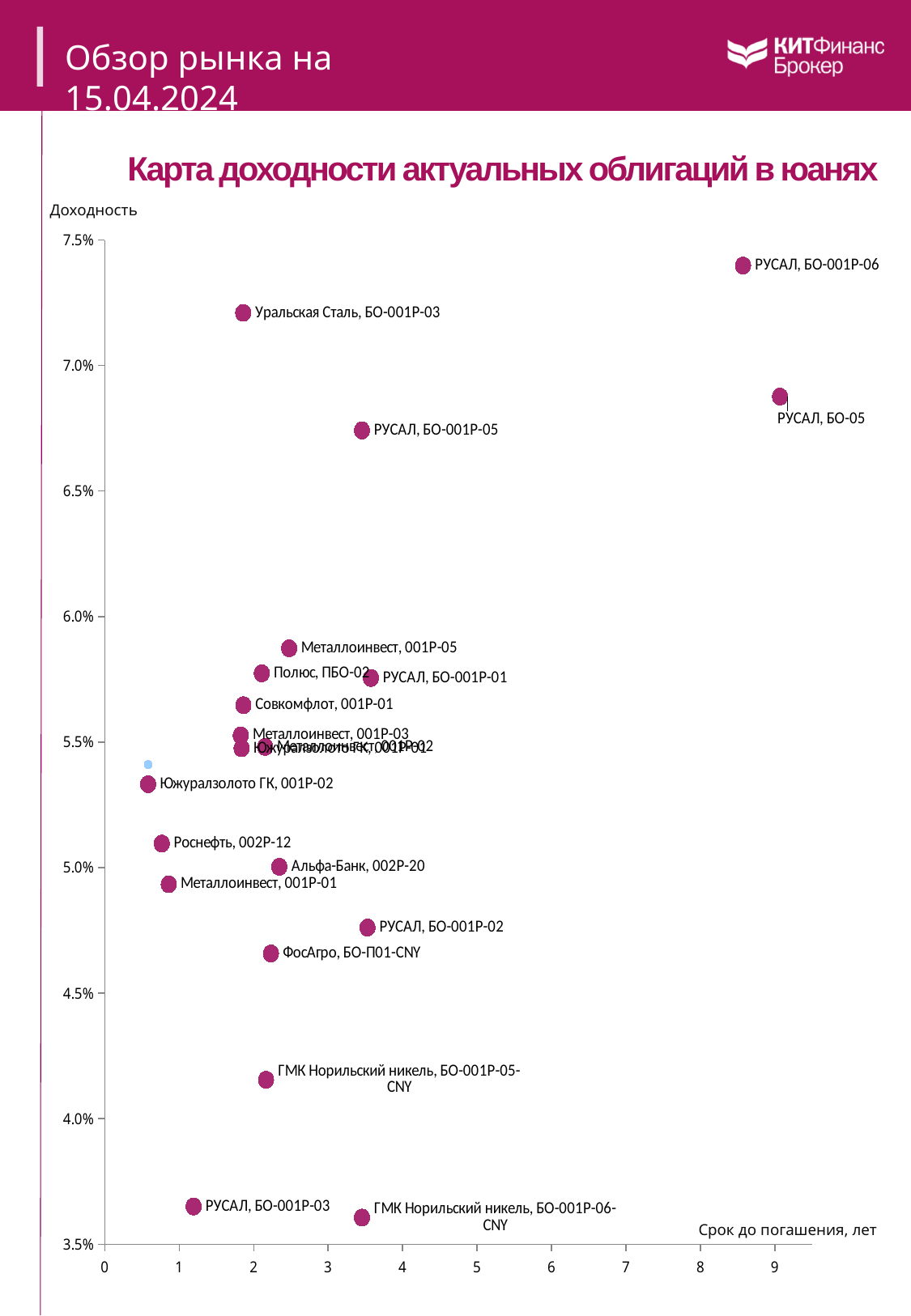
Is the yield for Роснефть, 002Р-12 greater or less than 5.0%? greater Is the yield for РУСАЛ, БО-001Р-05 greater or less than 7.0%? less What is the title of the chart? Карта доходности актуальных облигаций в юанях Is the yield for Уральская Сталь, БО-001Р-03 greater or less than 7.0%? greater What is the label of the horizontal axis of the chart? Срок до погашения, лет Which bond has the longer time to maturity: РУСАЛ, БО-001Р-01 or Полюс, ПБО-02? РУСАЛ, БО-001Р-01 Which bond has the highest yield (Доходность) on the chart? РУСАЛ, БО-001Р-06 Which bond has the higher yield: Уральская Сталь, БО-001Р-03 or Совкомфлот, 001Р-01? Уральская Сталь, БО-001Р-03 What kind of chart is shown on the slide? Scatter chart Which bond has the longest time to maturity (Срок до погашения) on the chart? РУСАЛ, БО-05